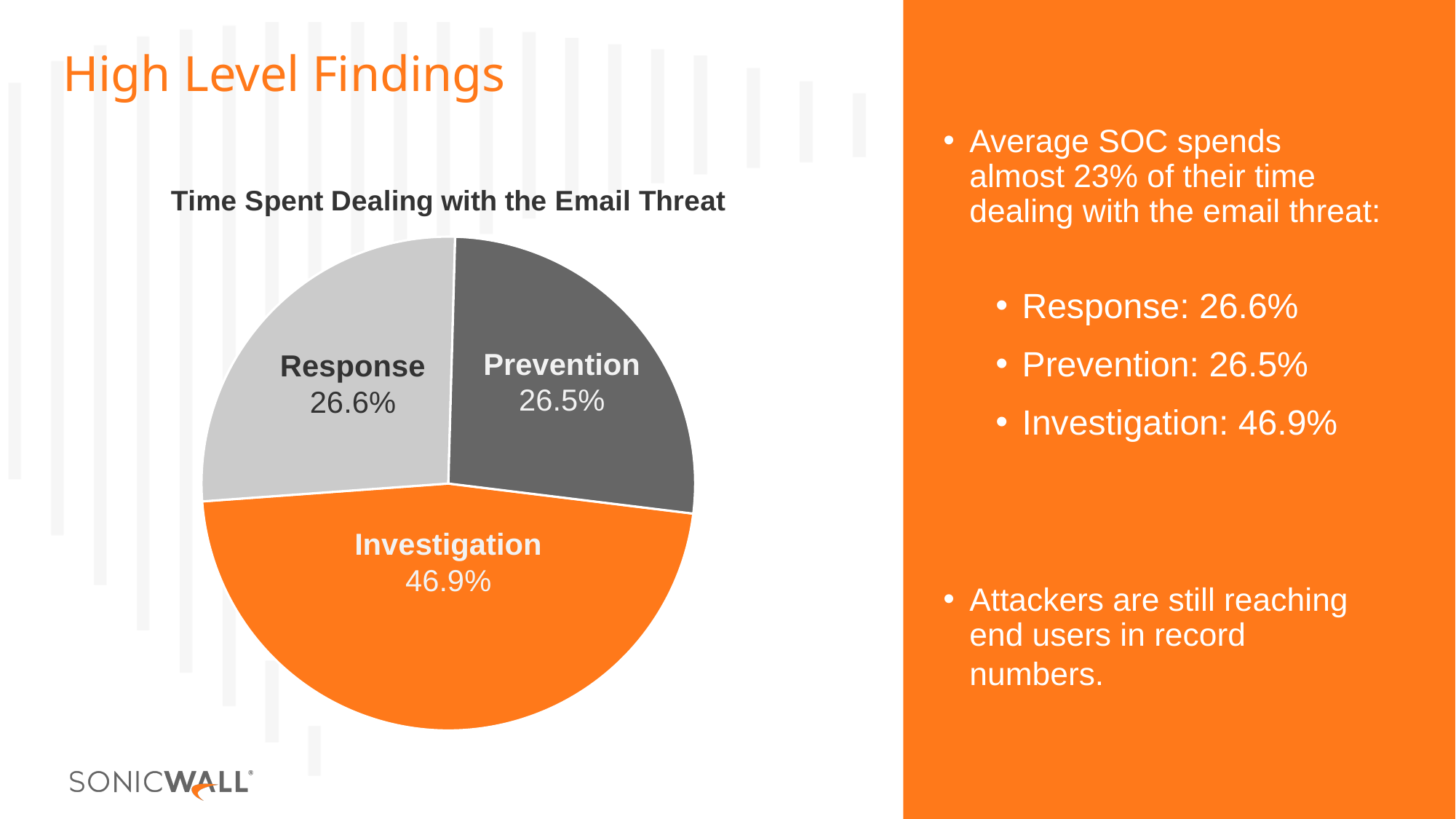
What colour is the Investigation slice? Orange What is the difference between the Investigation share and the Response share? 20.3% Is the share for Investigation greater or less than 50%? less What is the combined share of Response and Prevention? 53.1% What percentage of time is spent on Prevention? 26.5% What is the difference between the Investigation share and the Prevention share? 20.4% What type of chart is shown on the slide? Pie chart What is the title of the chart? Time Spent Dealing with the Email Threat Which category takes the largest share of time? Investigation How many slices does the pie chart have? 3 What percentage of time is spent on Investigation? 46.9% What percentage of time is spent on Response? 26.6%